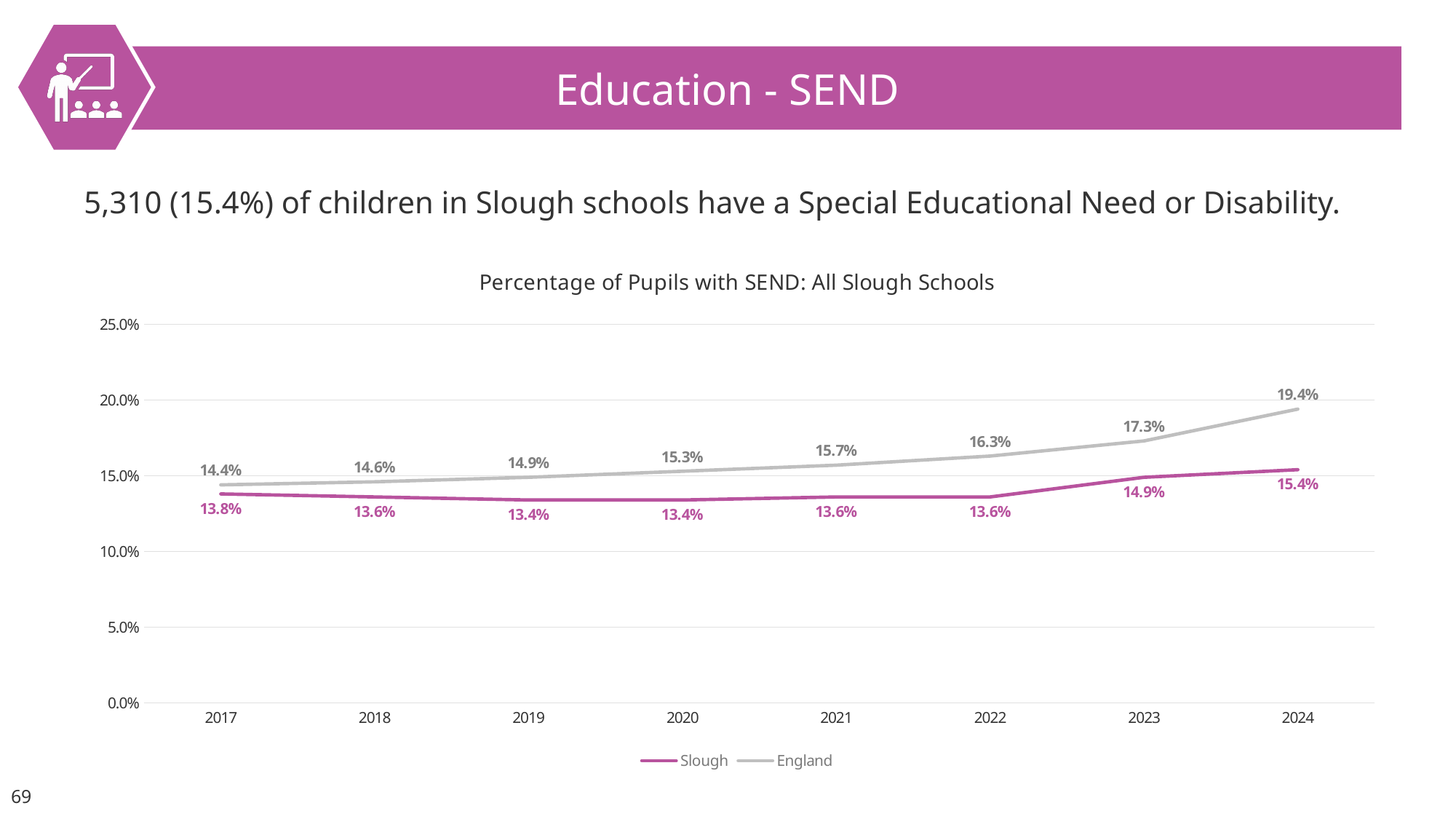
Which is larger in 2022, the Slough value or the England value? England Does the England series rise or fall from 2017 to 2024? rise What is the Slough value for 2017? 13.8% What is the difference between the England and Slough values in 2024? 4.0% Is the England value for 2024 greater or less than 15.0%? greater In which year is the England value highest? 2024 How many series does the legend list? 2 What kind of chart is shown? line chart What is the England value for 2019? 14.9% What is the lowest value shown for Slough? 13.4% How many years are shown on the x axis? 8 What is the Slough value for 2024? 15.4%